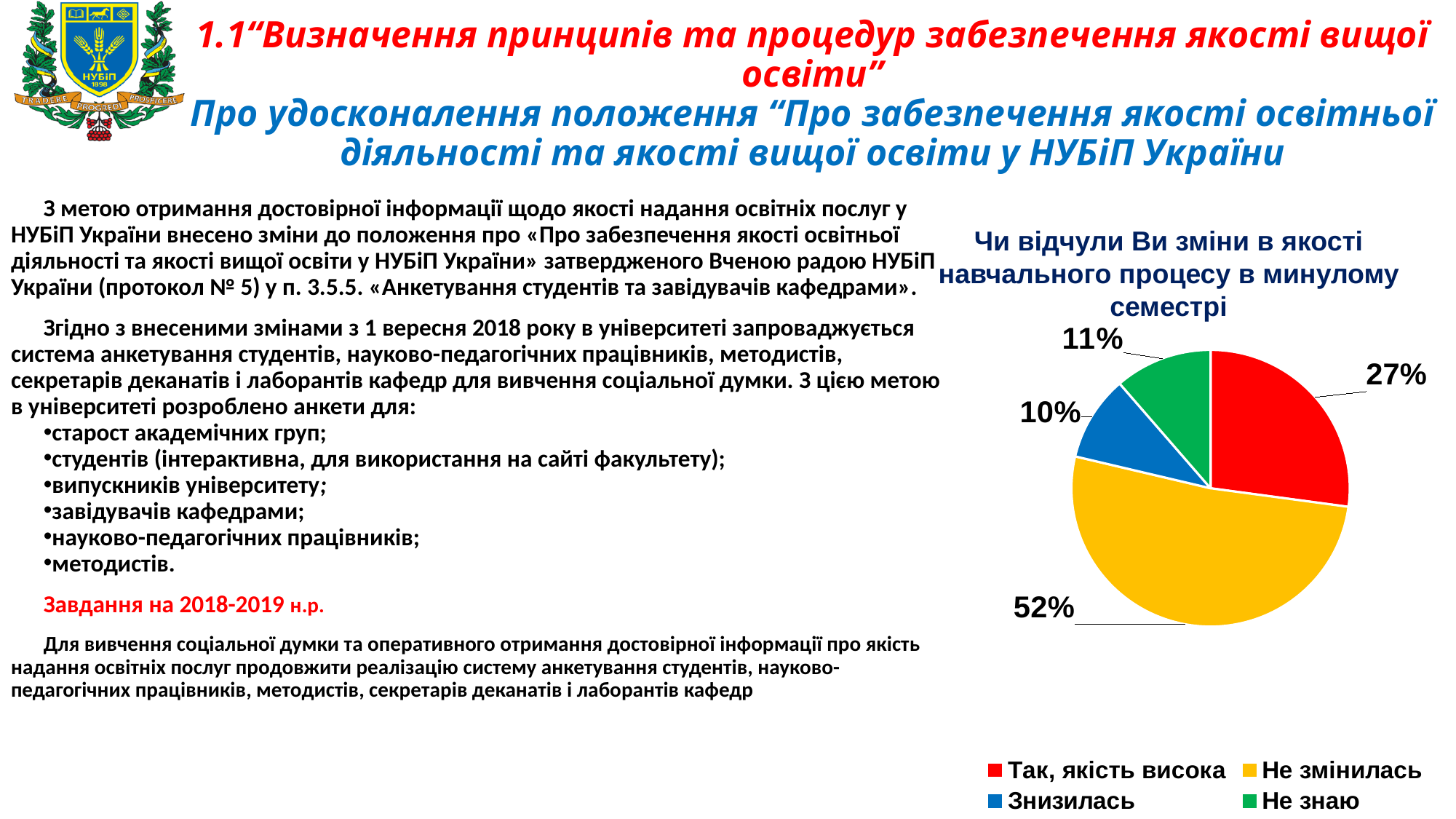
How many categories does the legend list? 4 Which category has the largest slice of the pie? Не змінилась Which is larger, the share for "Так, якість висока" or the share for "Не знаю"? Так, якість висока What colour is the slice for "Не змінилась"? yellow What share of the pie is labelled "Не змінилась"? 52% What share of the pie is labelled "Так, якість висока"? 27% What is the title of the chart? Чи відчули Ви зміни в якості навчального процесу в минулому семестрі What share of the pie is labelled "Знизилась"? 10% What share of the pie is labelled "Не знаю"? 11% What type of chart is shown on the slide? pie chart Which category has the smallest slice of the pie? Знизилась What is the difference between the shares for "Не змінилась" and "Так, якість висока"? 25%